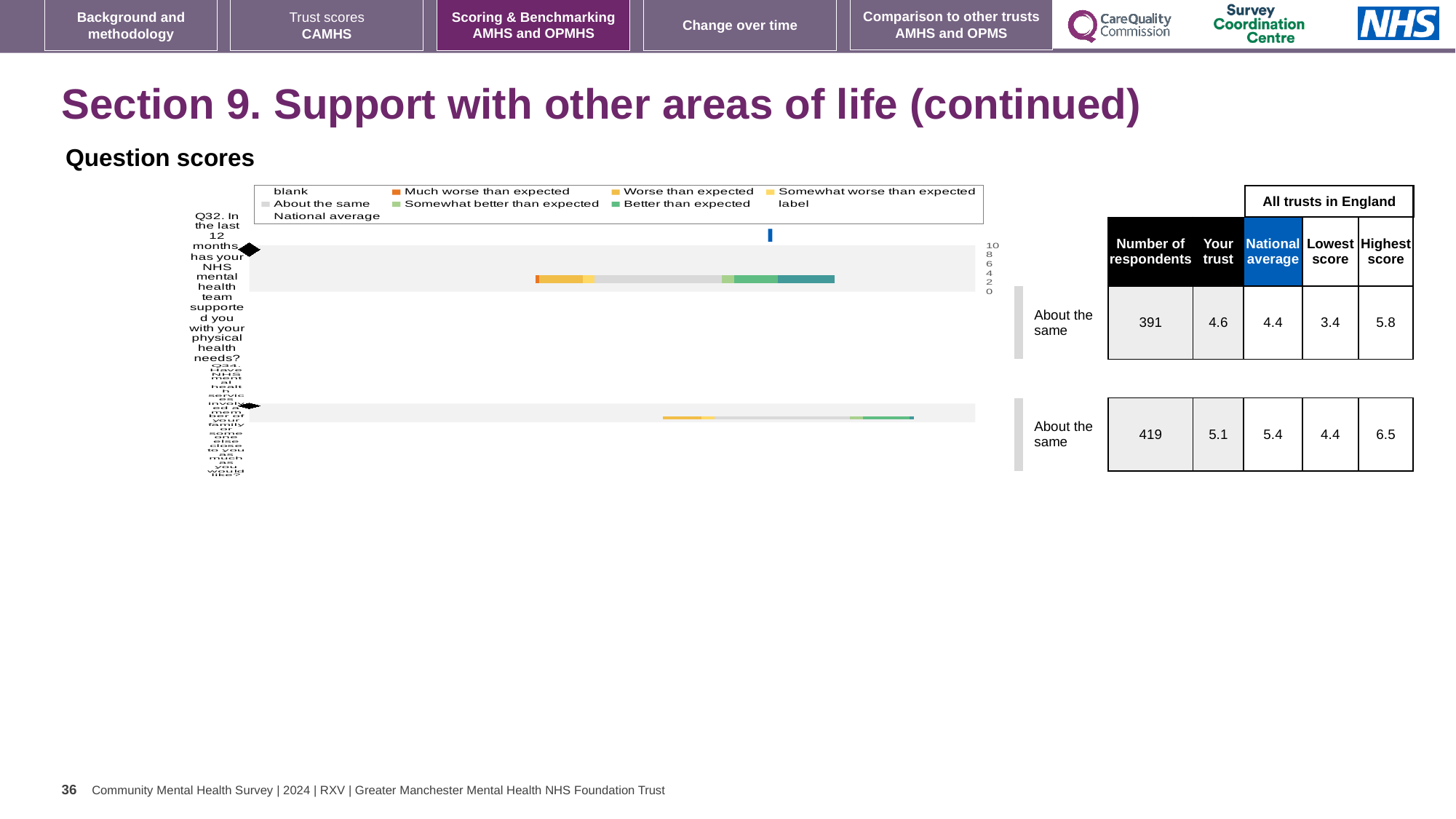
In the table next to the chart, what is the number of respondents for Q32? 391 In the table next to the chart, what is the highest score for Q34? 6.5 What is the difference between the 'Your trust' score and the national average for Q34? 0.3 How many questions (bars) are plotted in the chart? 2 What is the difference between the highest and lowest score for Q32 in the table? 2.4 In the table next to the chart, what is the lowest score for Q32? 3.4 What colour represents 'Much worse than expected' in the chart legend? orange In the table next to the chart, what is the 'Your trust' score for Q32? 4.6 In the table next to the chart, what is the national average for Q34? 5.4 What kind of chart is shown under 'Question scores'? bar chart Which question has more respondents in the table, Q32 or Q34? Q34 What benchmark label is shown beside both Q32 and Q34? About the same